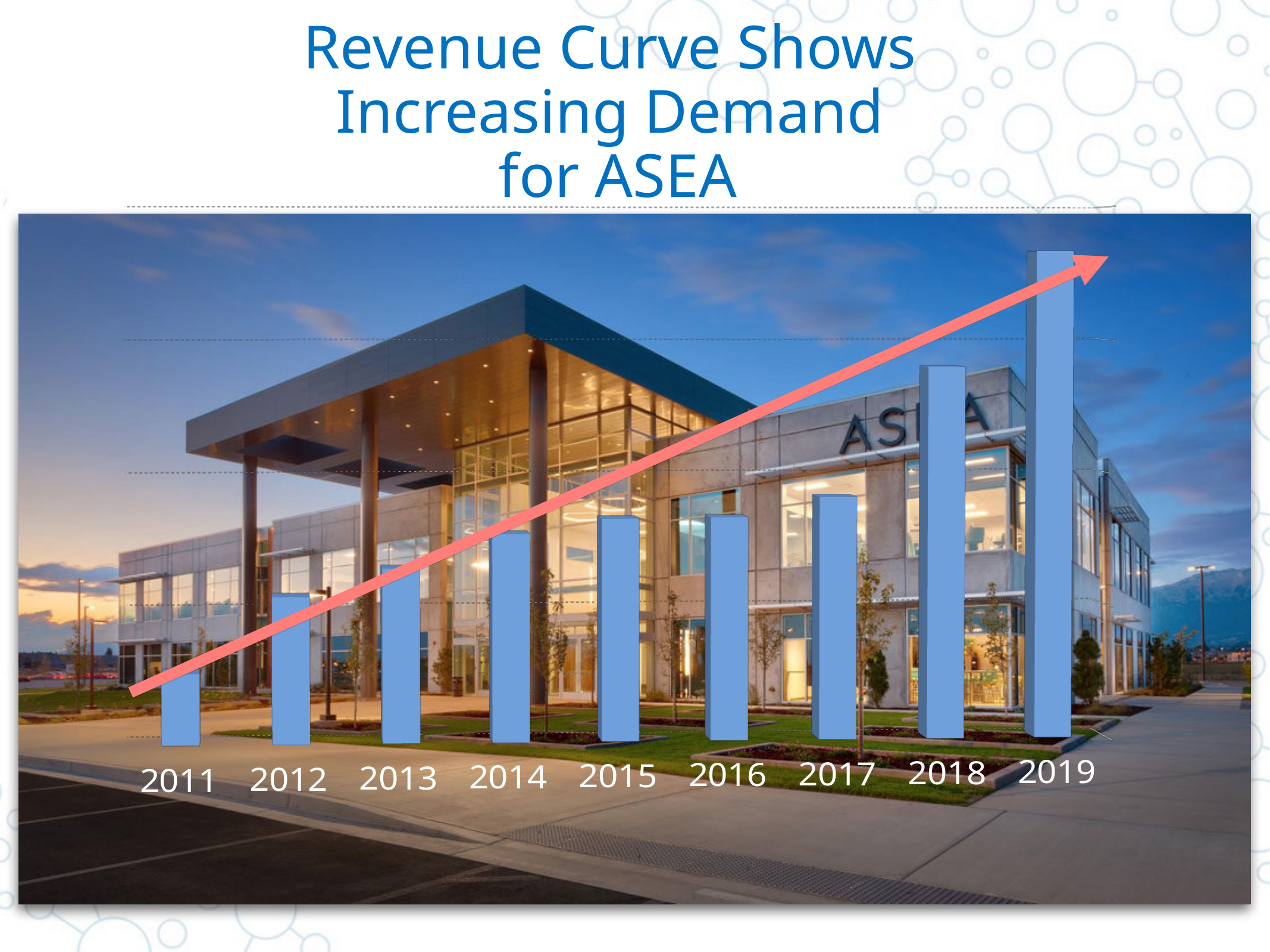
Which bar is taller, 2014 or 2017? 2017 How many years are shown on the x axis of the chart? 9 What is the first year shown on the x axis of the chart? 2011 Which bar is taller, 2012 or 2013? 2013 Do the bar values generally rise or fall from 2011 to 2019? rise What kind of chart is shown on the slide? bar chart Which year has the tallest bar in the chart? 2019 Which bar is taller, 2018 or 2019? 2019 Which year has the shortest bar in the chart? 2011 What is the title of the slide containing the chart? Revenue Curve Shows Increasing Demand for ASEA